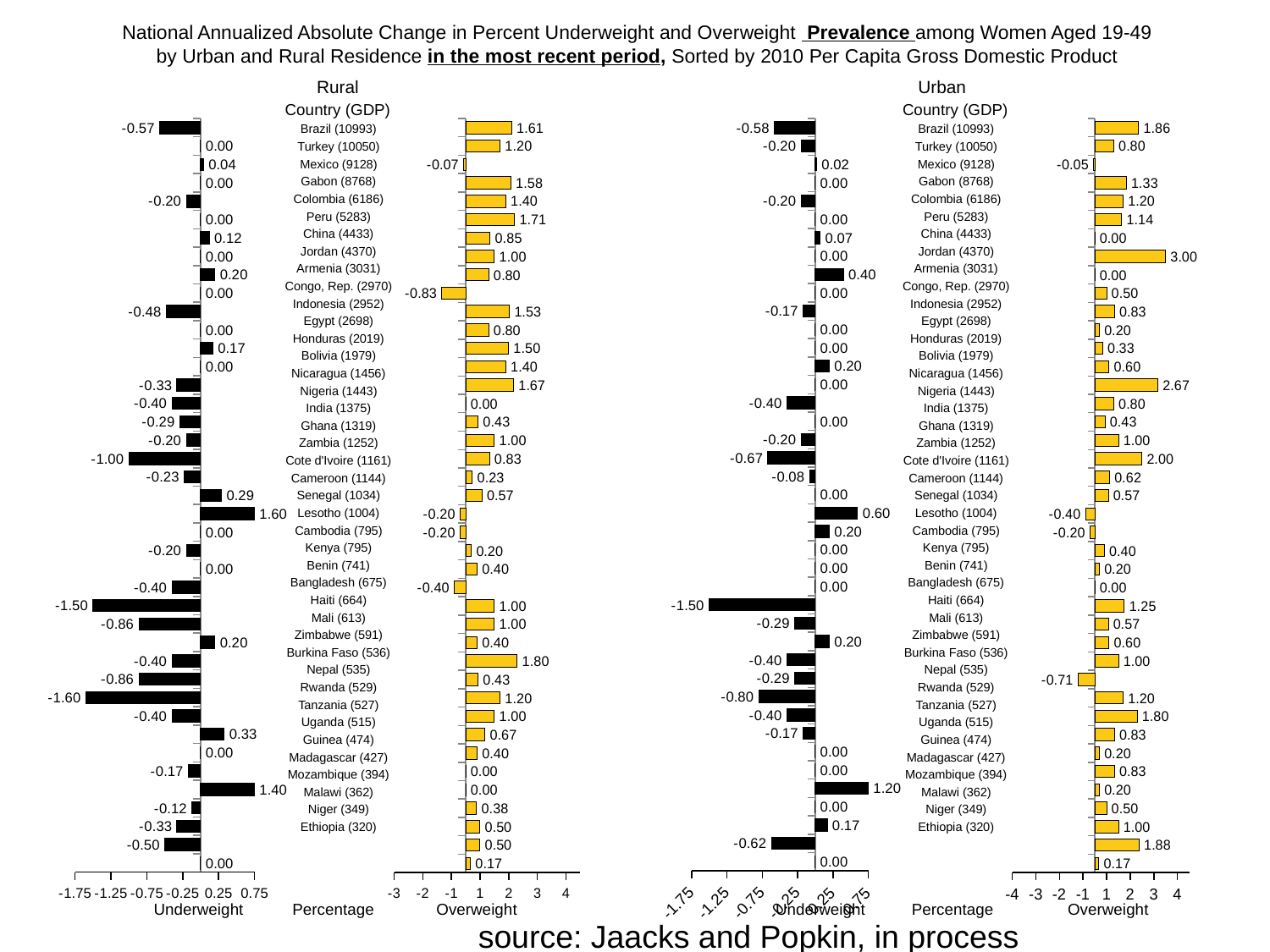
What is the lowest value shown in the Rural Underweight chart? -1.60 What kind of chart is used to show the Rural Underweight data? Bar chart How many countries are listed in the Rural Country (GDP) column? 41 In the Rural Underweight chart, what is the value for Brazil (10993)? -0.57 In the Urban Overweight chart, what is the value for Brazil (10993)? 1.86 In the Rural Overweight chart, what is the value for Peru (5283)? 1.71 What colour are the bars in the Overweight charts? Yellow In the Urban Underweight chart, what is the value for Turkey (10050)? -0.20 What is the difference between the Urban Overweight value for Brazil (10993) and the Rural Overweight value for Brazil (10993)? 0.25 What is the highest value shown in the Urban Overweight chart? 3.00 What is the lowest value shown in the Rural Overweight chart? -0.83 For Brazil (10993), is the Overweight value larger in the Rural chart or the Urban chart? Urban